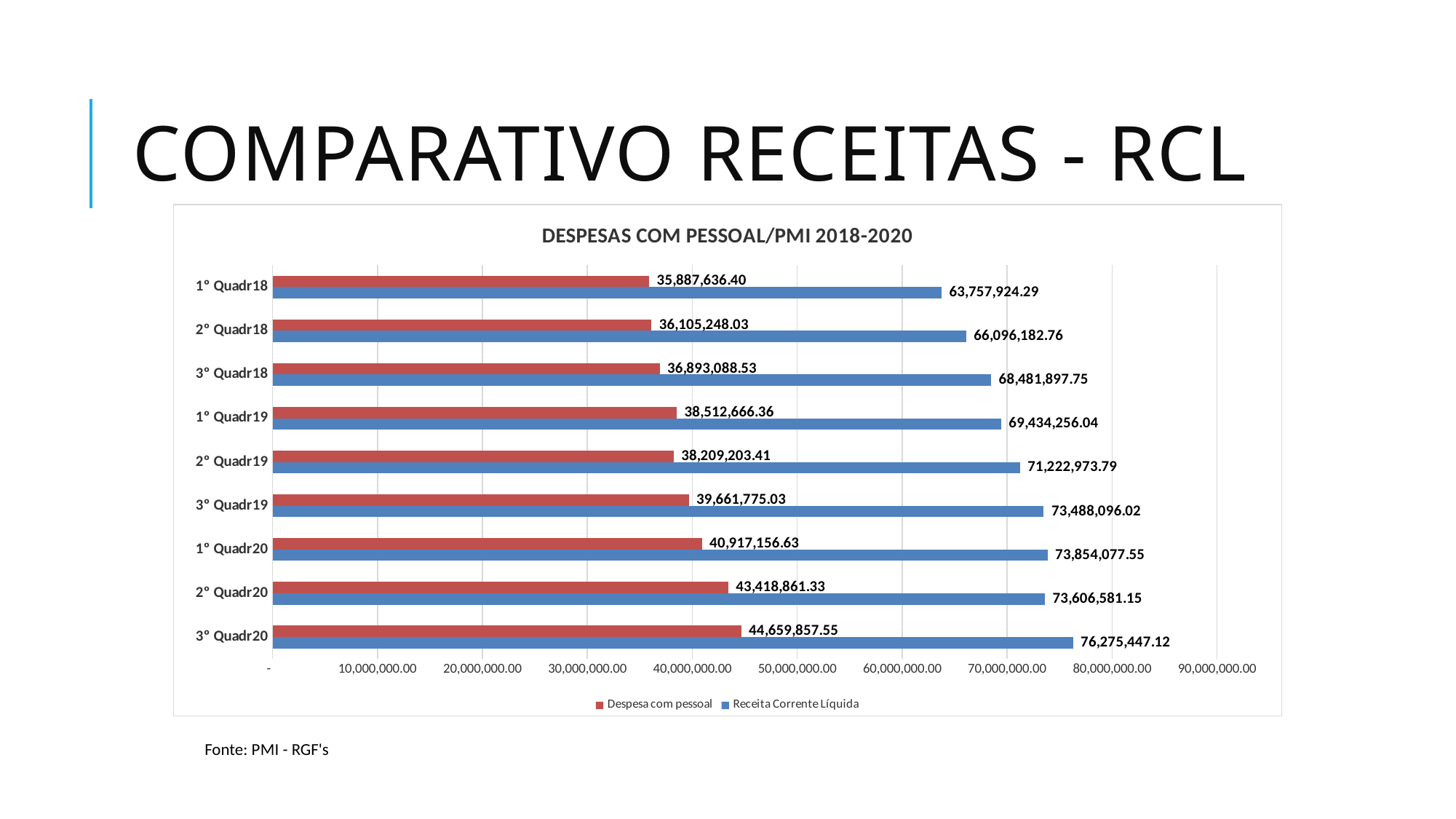
Which is larger: Despesa com pessoal for 2° Quadr20 or for 1° Quadr20? 2° Quadr20 What is the value of Receita Corrente Líquida for 2° Quadr19? 71,222,973.79 What is the difference between Receita Corrente Líquida and Despesa com pessoal for 3° Quadr20? 31,615,589.57 How many series does the legend list? 2 Which category has the highest Receita Corrente Líquida? 3° Quadr20 Is the Receita Corrente Líquida for 1° Quadr18 greater or less than 60,000,000.00? greater How many categories are shown on the chart? 9 What is the value of Despesa com pessoal for 1° Quadr20? 40,917,156.63 What is the value of Despesa com pessoal for 1° Quadr18? 35,887,636.40 What type of chart is shown? bar chart What is the value of Receita Corrente Líquida for 3° Quadr20? 76,275,447.12 Which category has the lowest Despesa com pessoal? 1° Quadr18